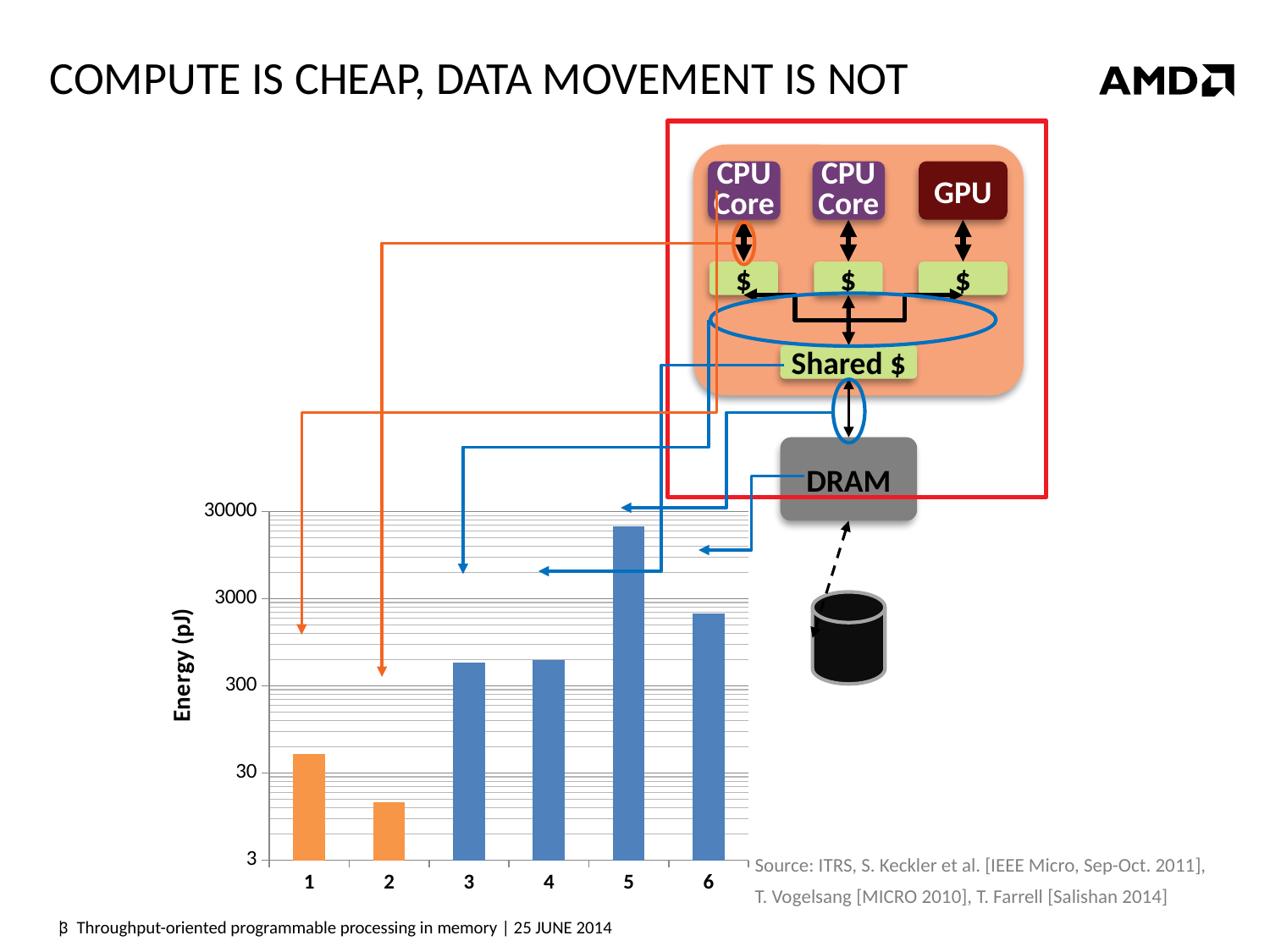
Is the value for category 3 greater or less than 300? greater Which category has the highest bar in the chart? 5 What is the title of the y axis of the chart? Energy (pJ) Is the value for category 1 greater or less than 30? greater Which is larger, the value for category 1 or the value for category 2? 1 Is the value for category 6 greater or less than 3000? less How many categories are plotted on the x axis of the chart? 6 Which is larger, the value for category 5 or the value for category 6? 5 What kind of chart is shown on the slide? bar chart Which category has the lowest bar in the chart? 2